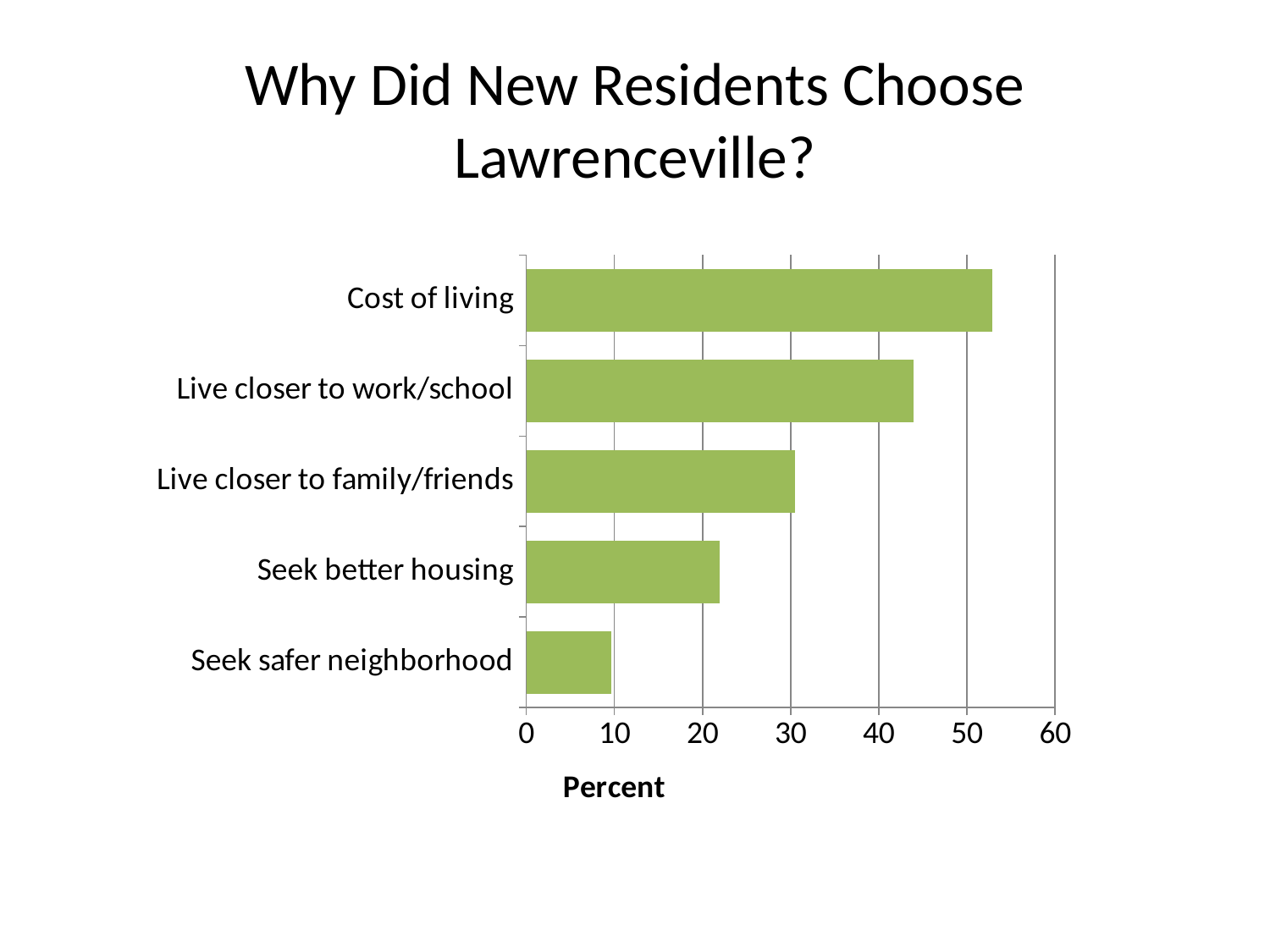
Which reason has the lowest percentage? Seek safer neighborhood Is the value for Seek better housing greater or less than 30? less Is the value for Live closer to family/friends greater or less than 20? greater Is the value for Live closer to work/school greater or less than 40? greater How many categories (reasons) are plotted in the chart? 5 What is the label on the horizontal axis of the chart? Percent What is the title of the chart on the slide? Why Did New Residents Choose Lawrenceville? Which reason has the highest percentage? Cost of living What kind of chart is shown on the slide? bar chart Which is larger: the value for Live closer to work/school or the value for Seek better housing? Live closer to work/school